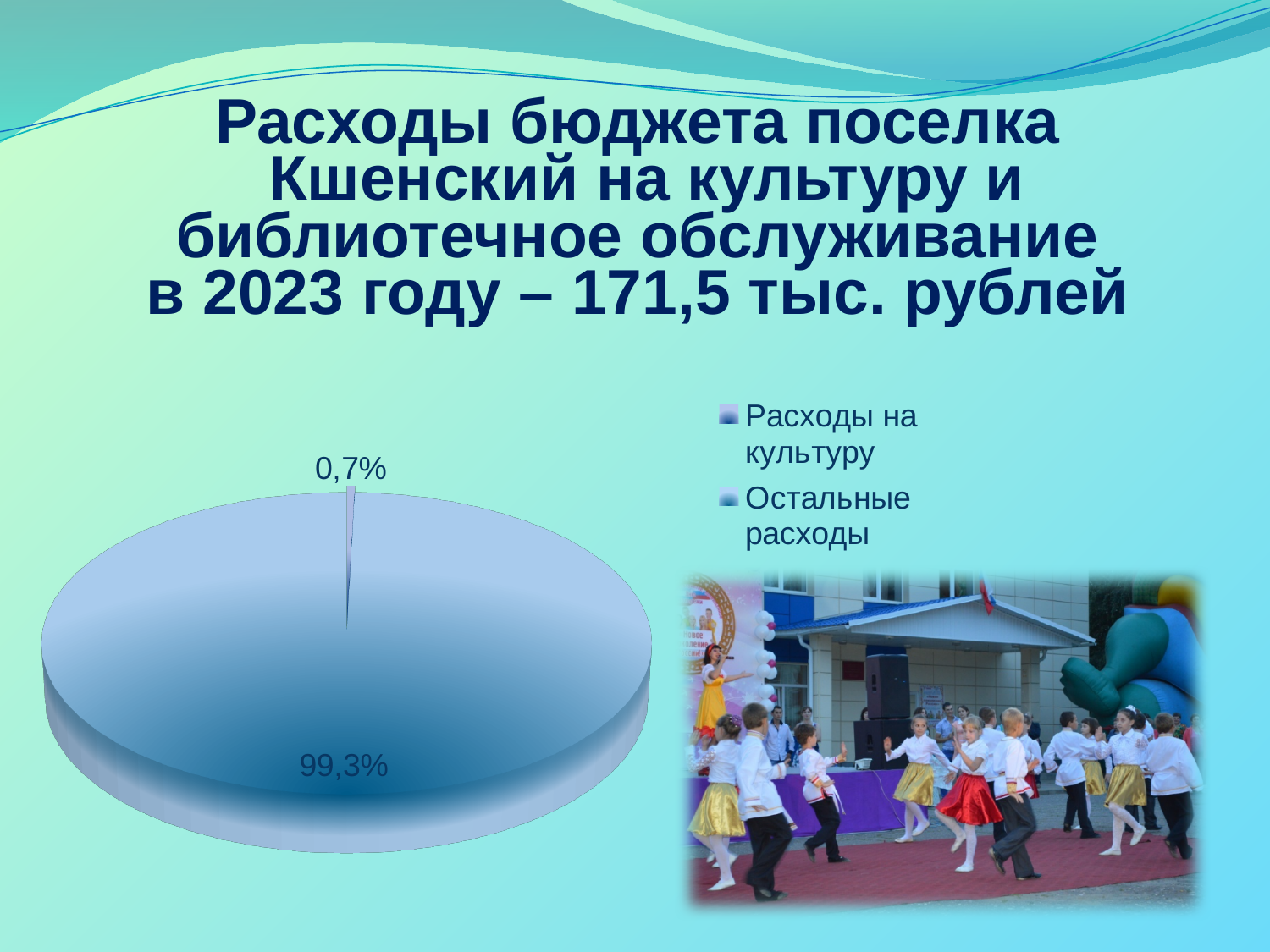
Which category has the smallest slice in the pie chart? Расходы на культуру What is the first entry listed in the legend of the pie chart? Расходы на культуру What is the difference between the two slices of the pie chart? 98,6% What share of the pie is labelled for the large slice? 99,3% What is the value shown for "Расходы на культуру" in the pie chart? 0,7% Which category has the largest slice in the pie chart? Остальные расходы What kind of chart is shown on the slide? pie chart How many entries does the legend of the pie chart list? 2 What is the value shown for "Остальные расходы" in the pie chart? 99,3% How many slices does the pie chart have? 2 What share of the pie is labelled for the small slice? 0,7% Which is larger in the pie chart: "Расходы на культуру" or "Остальные расходы"? Остальные расходы